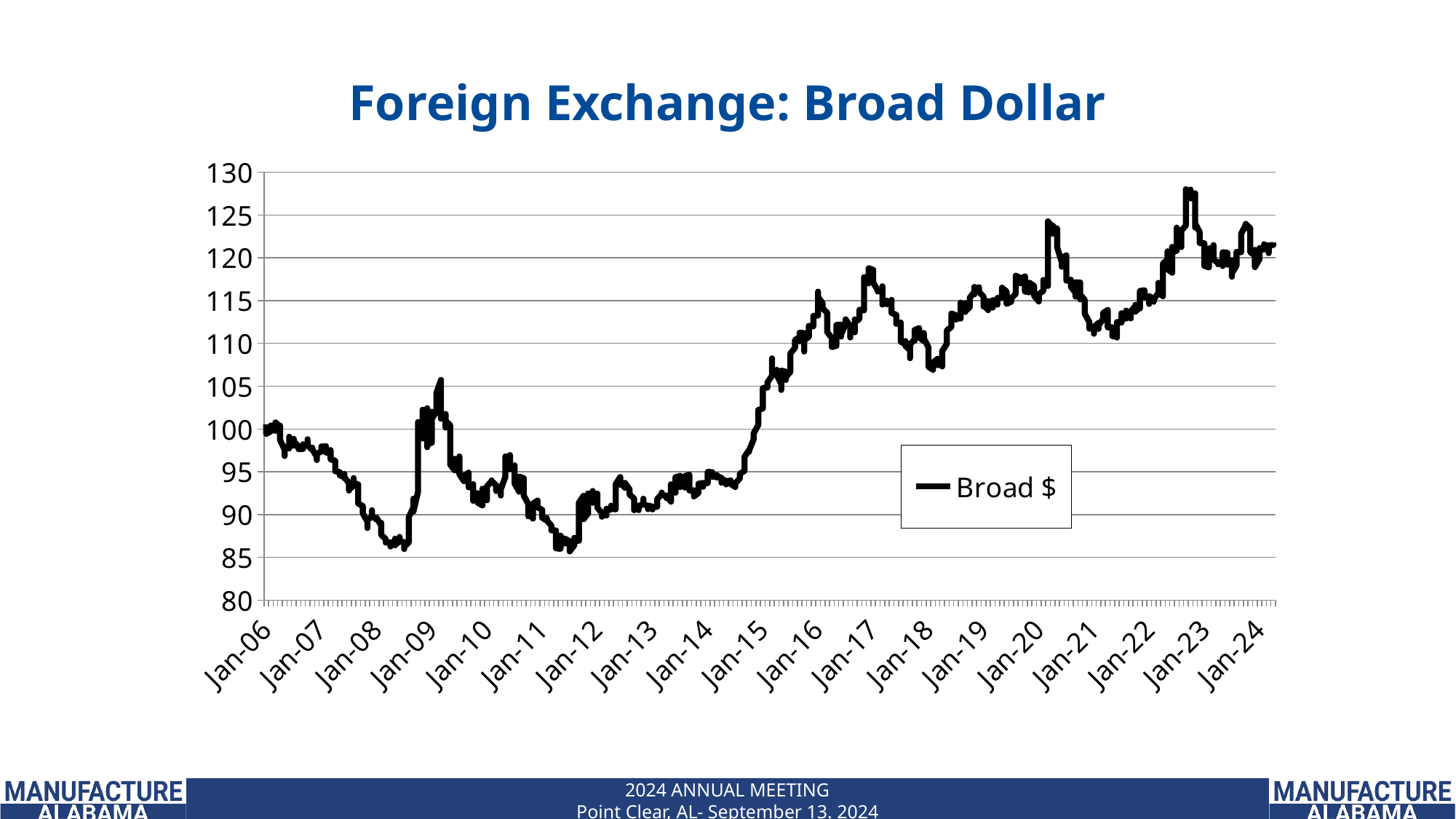
How many series does the legend list? 1 What is the name of the series shown in the legend? Broad $ Is the value for Broad $ at Jan-16 greater or less than 110? greater What kind of chart is shown on the slide? line chart What is the title of the chart? Foreign Exchange: Broad Dollar How many year labels are shown on the x axis? 19 Overall, does the Broad $ value rise or fall from Jan-06 to Jan-24? rise Is the value for Broad $ at Jan-11 greater or less than 95? less Is the highest value reached by Broad $ on the chart greater or less than 125? greater